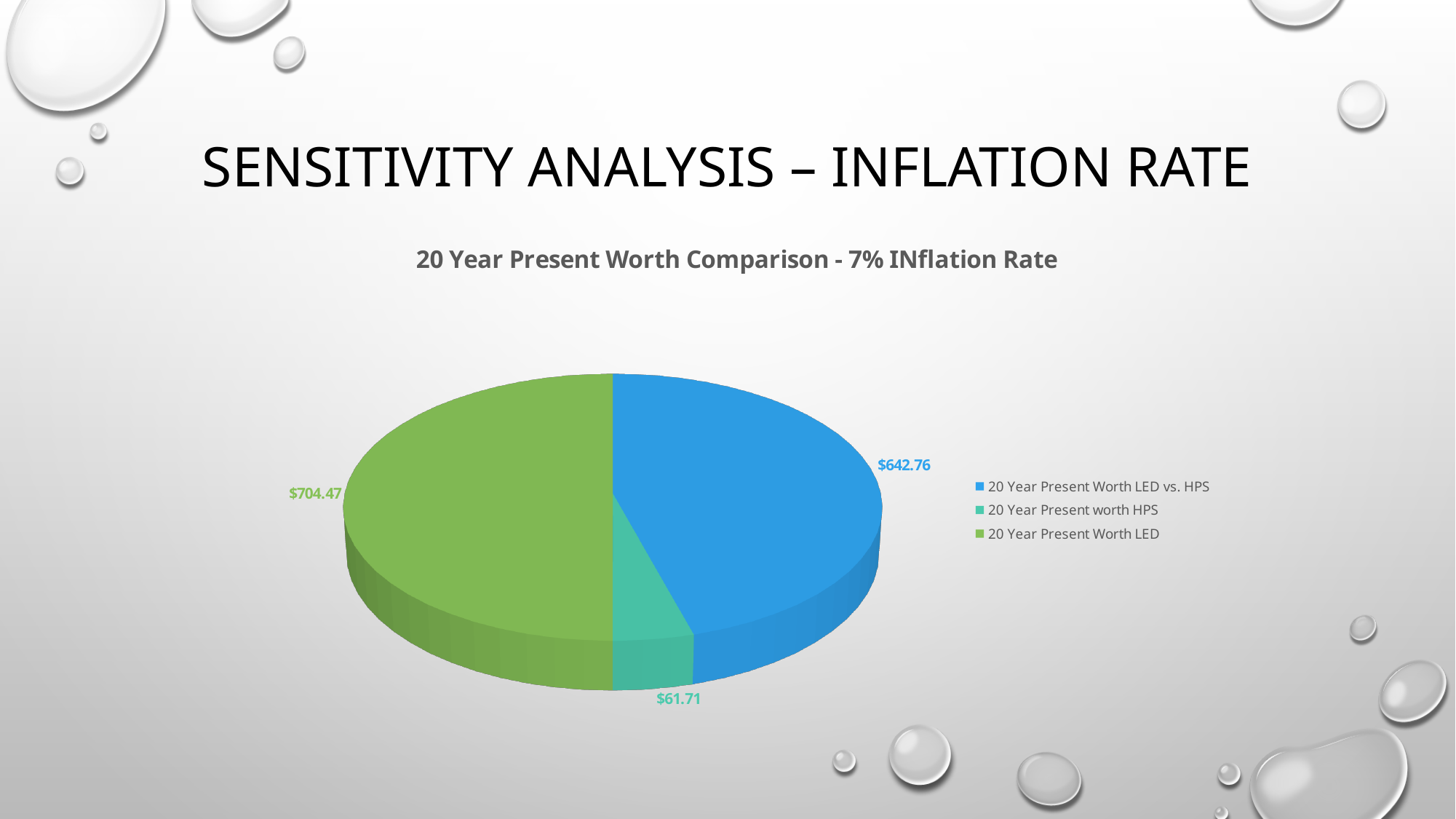
What is the difference between the 20 Year Present Worth LED vs. HPS value and the 20 Year Present worth HPS value? $581.05 What is the value of the 20 Year Present worth HPS slice? $61.71 What type of chart is shown on the slide? Pie chart How many slices does the pie chart have? 3 Which slice has the largest value? 20 Year Present Worth LED Which is larger, the 20 Year Present Worth LED slice or the 20 Year Present Worth LED vs. HPS slice? 20 Year Present Worth LED What is the difference between the 20 Year Present Worth LED value and the 20 Year Present Worth LED vs. HPS value? $61.71 What is the value of the 20 Year Present Worth LED slice? $704.47 What is the value of the 20 Year Present Worth LED vs. HPS slice? $642.76 What is the title of the chart? 20 Year Present Worth Comparison - 7% INflation Rate What share of the pie does the 20 Year Present Worth LED slice represent? 50% Which slice has the smallest value? 20 Year Present worth HPS